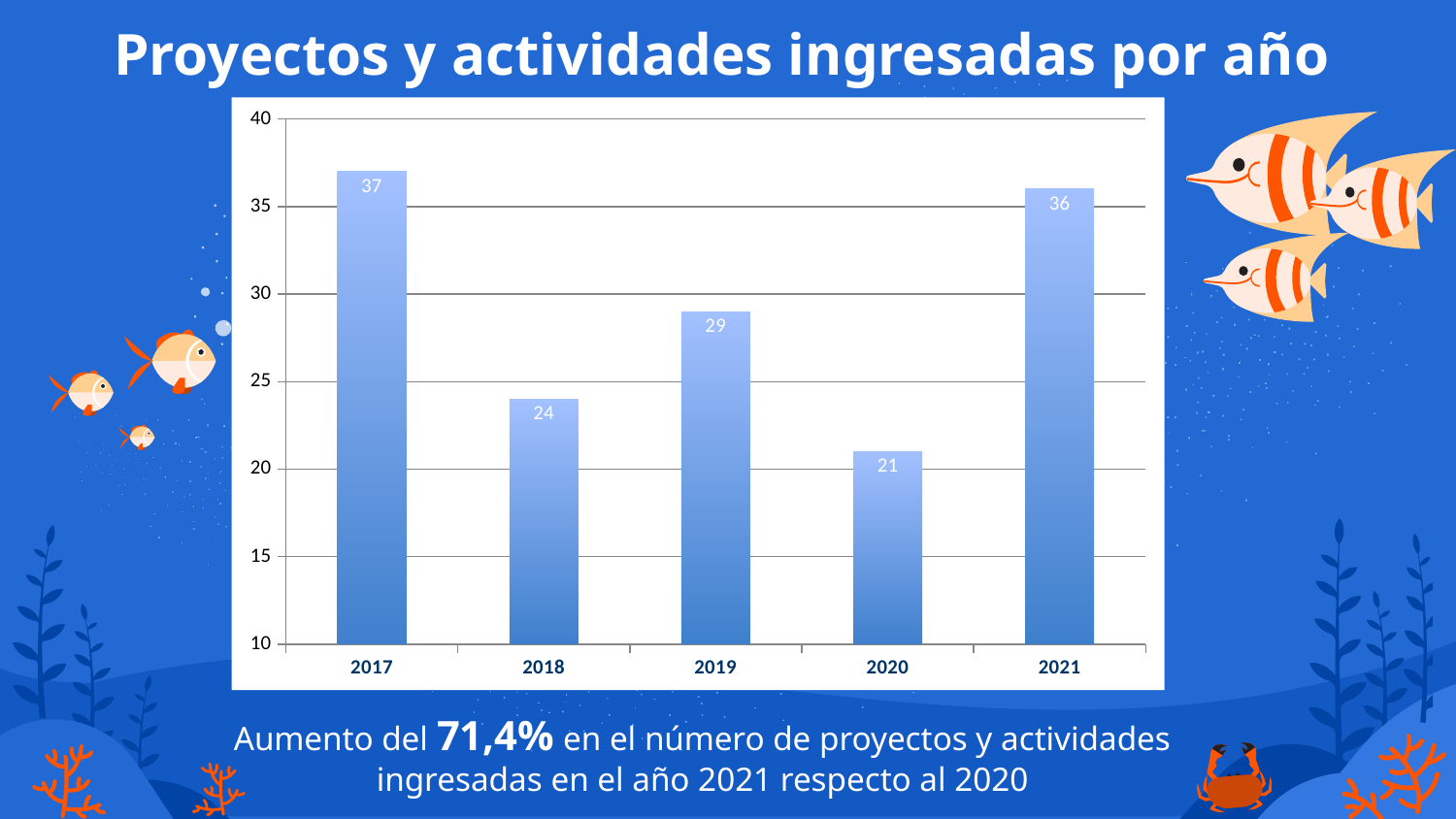
What is the title of the slide? Proyectos y actividades ingresadas por año Which year has the lowest value? 2020 How many years are shown on the x axis? 5 What is the difference between the values for 2021 and 2020? 15 Is the value for 2019 greater or less than 25? greater Which is larger, the value for 2018 or the value for 2019? 2019 What is the difference between the values for 2019 and 2018? 5 What is the value for 2021? 36 What is the value for 2017? 37 What kind of chart is shown on the slide? bar chart Which year has the highest value? 2017 What is the value for 2020? 21